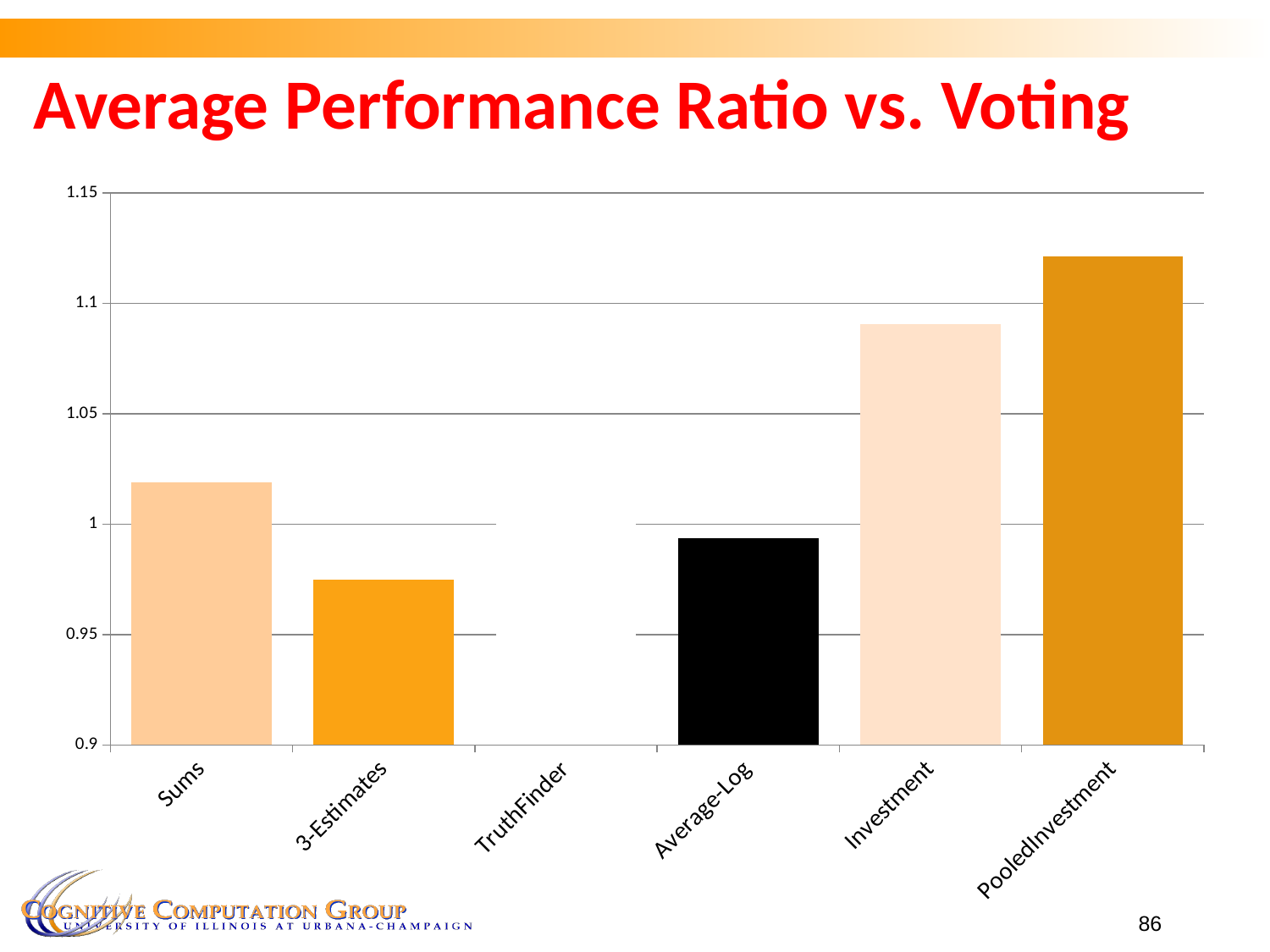
How many categories are shown on the x axis of the chart? 6 Which is larger, the value for Investment or the value for PooledInvestment? PooledInvestment What is the title of the slide containing the chart? Average Performance Ratio vs. Voting Is the value for 3-Estimates greater or less than 1? less Which category has the highest bar in the chart? PooledInvestment Is the value for Investment greater or less than 1.1? less Which is larger, the value for Sums or the value for 3-Estimates? Sums Is the value for Sums greater or less than 1? greater Which is larger, the value for Average-Log or the value for Sums? Sums What kind of chart is shown on the slide? bar chart